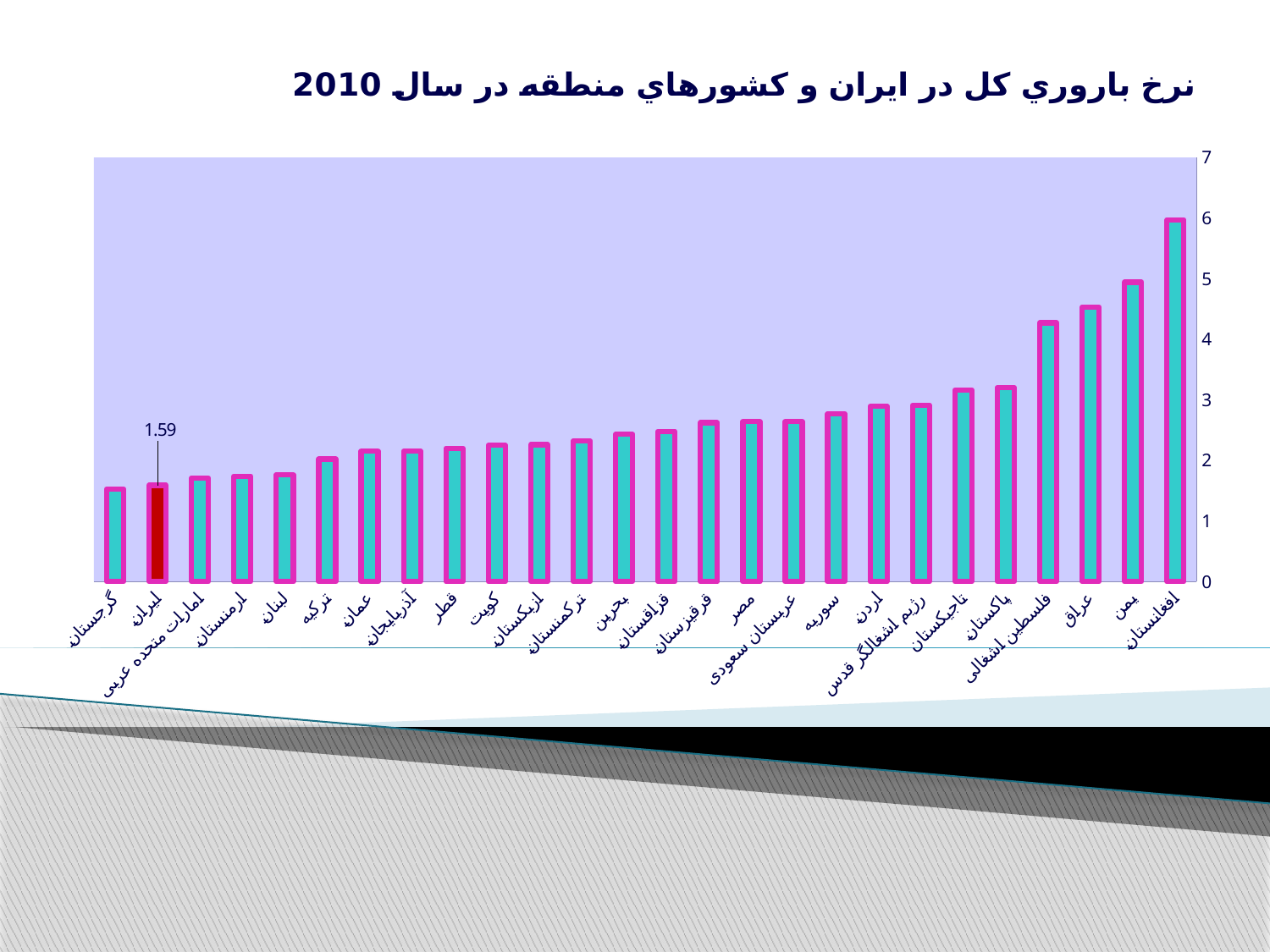
Which country has the highest bar? افغانستان Which country has the lowest bar? گرجستان How many countries are shown on the chart? 26 Which is larger, the value for افغانستان or the value for یمن? افغانستان Is the value for افغانستان greater or less than 5? greater Is the value for گرجستان greater or less than 2? less Which country's bar is coloured red instead of teal? ایران Is the value for مصر greater or less than 3? less Do the bar values rise or fall from left to right along the x axis? Rise What type of chart is shown on the slide? Bar chart What is the value shown for ایران (Iran)? 1.59